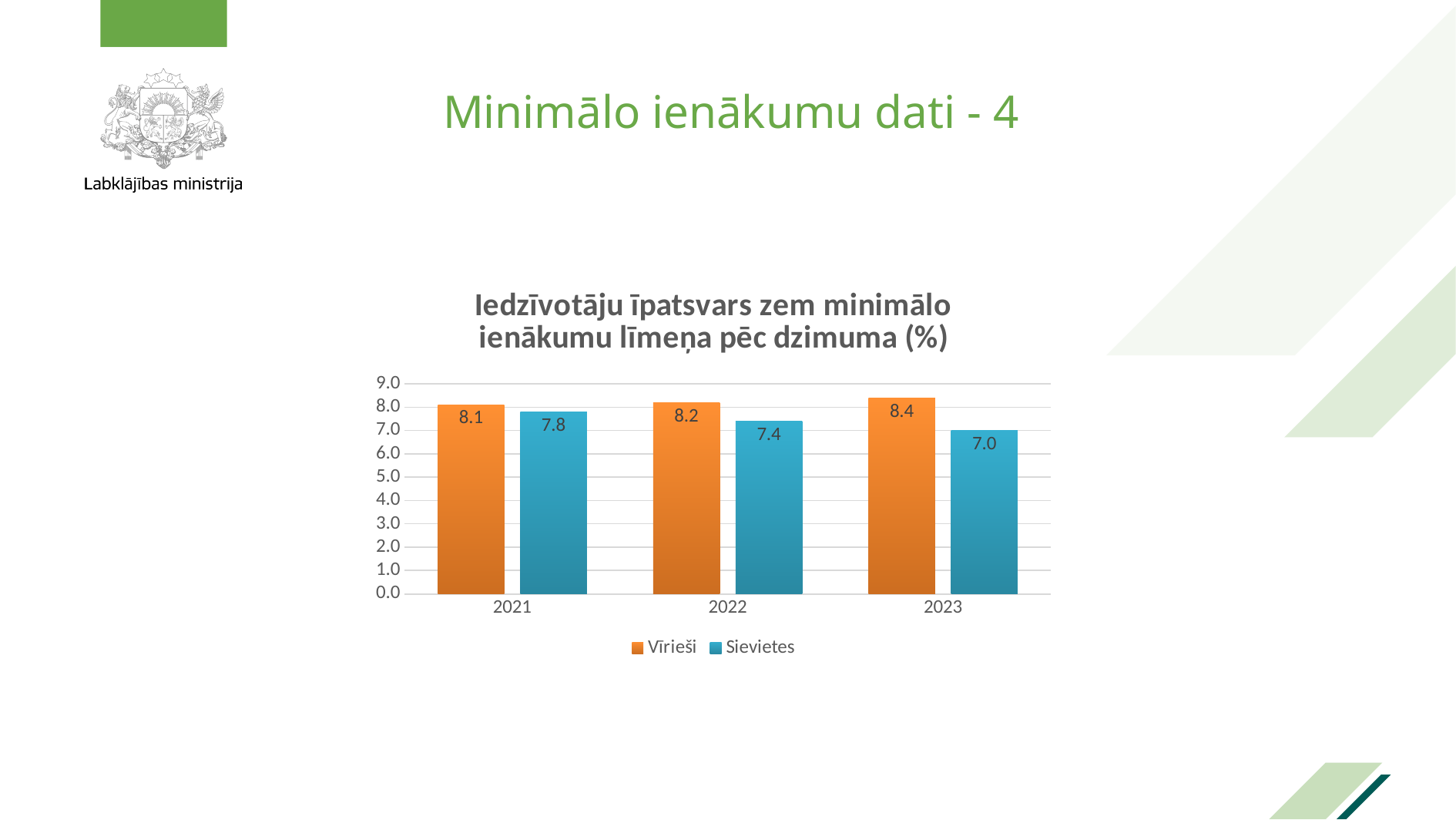
How many series does the legend list? 2 Do the values for Sievietes rise or fall from 2021 to 2023? Fall Which is larger in 2022, the value for Vīrieši or for Sievietes? Vīrieši What is the value for Sievietes in 2022? 7.4 In which year is the value for Vīrieši highest? 2023 What is the difference between the Vīrieši and Sievietes values in 2023? 1.4 What is the value for Sievietes in 2023? 7.0 How many years are shown on the x axis? 3 In which year is the value for Sievietes lowest? 2023 What colour are the bars for Sievietes? Blue What is the value for Vīrieši in 2021? 8.1 What kind of chart is shown on the slide? Bar chart